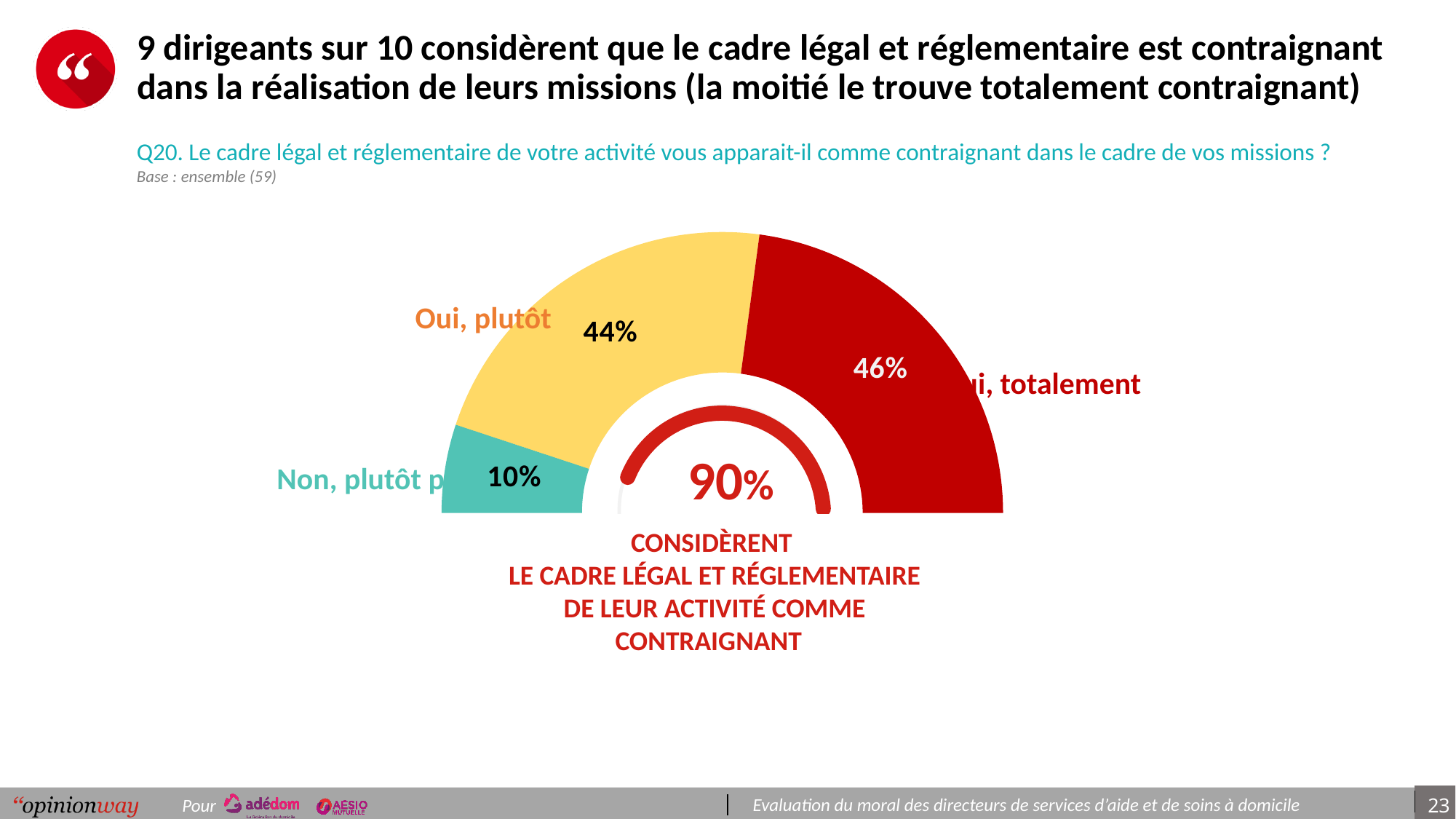
Which response category has the largest share? Oui, totalement What percentage of respondents answered "Oui, plutôt"? 44% What colour is the "Oui, totalement" segment? Red Which response category has the smallest share? Non, plutôt What percentage of respondents answered "Oui, totalement"? 46% What kind of chart is shown on the slide? Half-donut (semi-circular pie) chart What is the difference in percentage points between "Oui, plutôt" and the "Non, plutôt" segment? 34 percentage points Which is larger, the share for "Oui, totalement" or for "Oui, plutôt"? Oui, totalement How many segments does the chart have? 3 What percentage is shown for the teal "Non, plutôt" segment? 10% What is the difference in percentage points between "Oui, totalement" and "Oui, plutôt"? 2 percentage points What is the combined share of "Oui, plutôt" and "Oui, totalement"? 90%